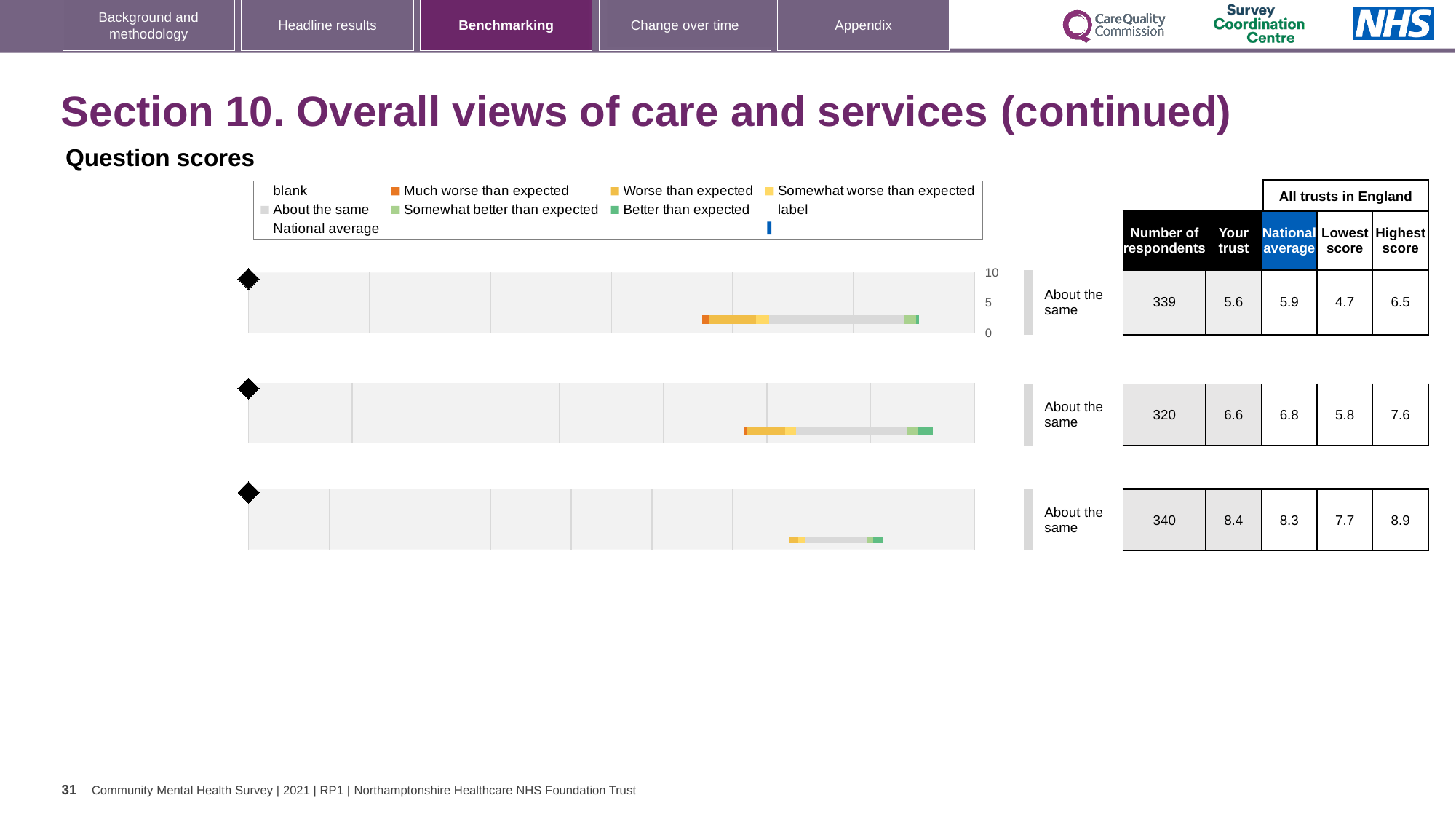
Which chart (top, middle or bottom) has the highest 'Your trust' score? bottom For the top chart, what is the 'Your trust' score shown in the table beside it? 5.6 What kind of chart is used to show the question scores on this slide? bar chart For the bottom chart, which is larger: the 'Your trust' score or the national average? Your trust In the legend, which colour represents 'Better than expected'? green For the top chart, what is the difference between the highest score and the lowest score in the table beside it? 1.8 How many question score charts are shown on the slide? 3 What benchmark category is shown next to the middle chart? About the same For the bottom chart, how many respondents are shown in the table beside it? 340 In the legend, which colour represents 'Much worse than expected'? orange For the middle chart, what is the lowest score among all trusts in England shown in the table beside it? 5.8 For the middle chart, what is the national average score shown in the table beside it? 6.8